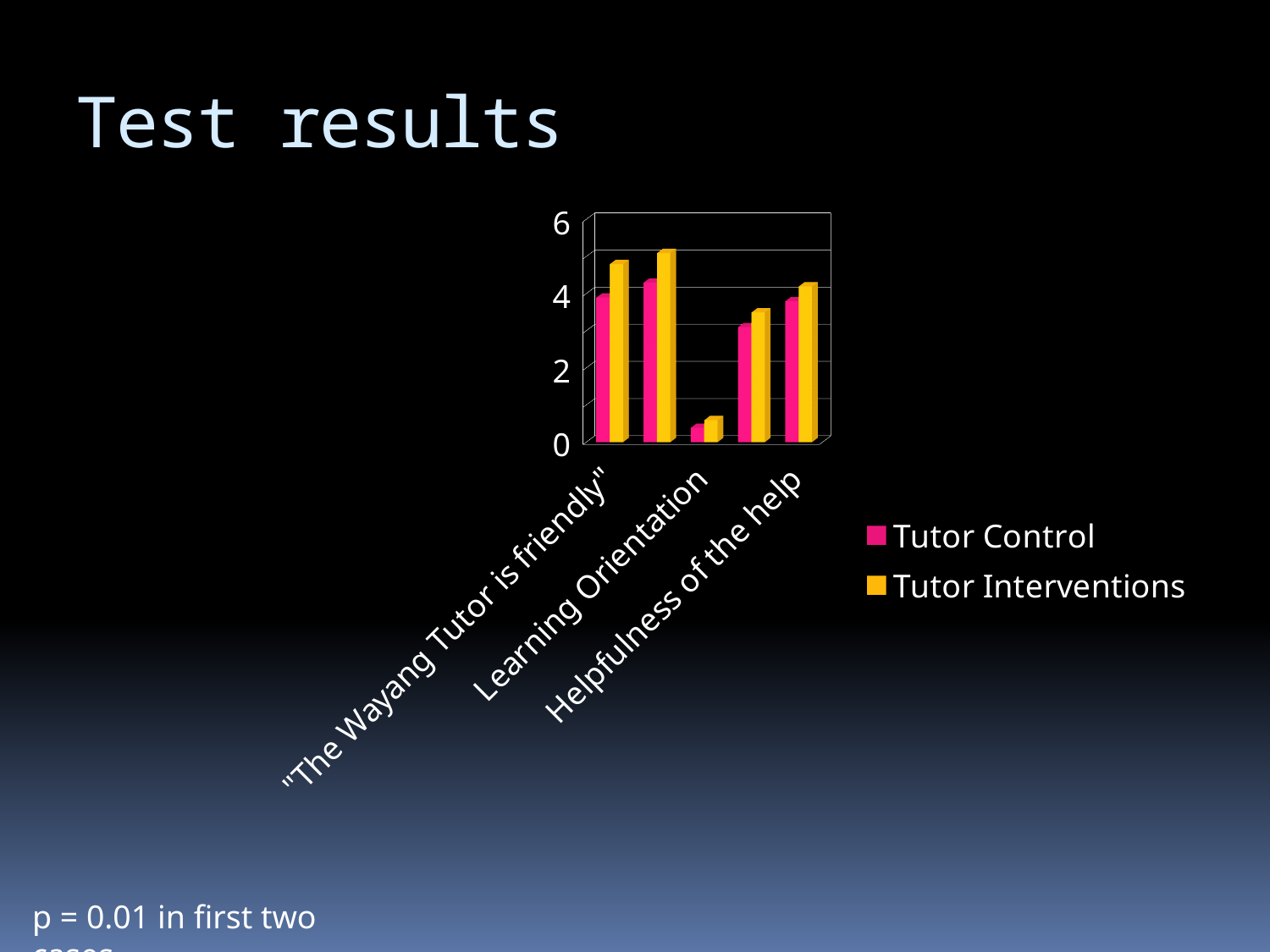
What is the highest value shown on the chart's vertical axis? 6 Which group of bars, counting from the left, contains the tallest bar in the chart? the second group In every group of bars, which series has the taller bar, Tutor Control or Tutor Interventions? Tutor Interventions How many series does the chart legend list? 2 Is the Tutor Control value in the third group of bars from the left greater or less than 2? less What colour represents the Tutor Interventions series in the chart? yellow Is the Tutor Interventions value in the second group of bars from the left greater or less than 4? greater What kind of chart is shown on the slide? bar chart What are the two series named in the chart legend? Tutor Control and Tutor Interventions Is the Tutor Control value in the fourth group of bars from the left greater or less than 4? less Which group of bars, counting from the left, has the lowest values for both series? the third group